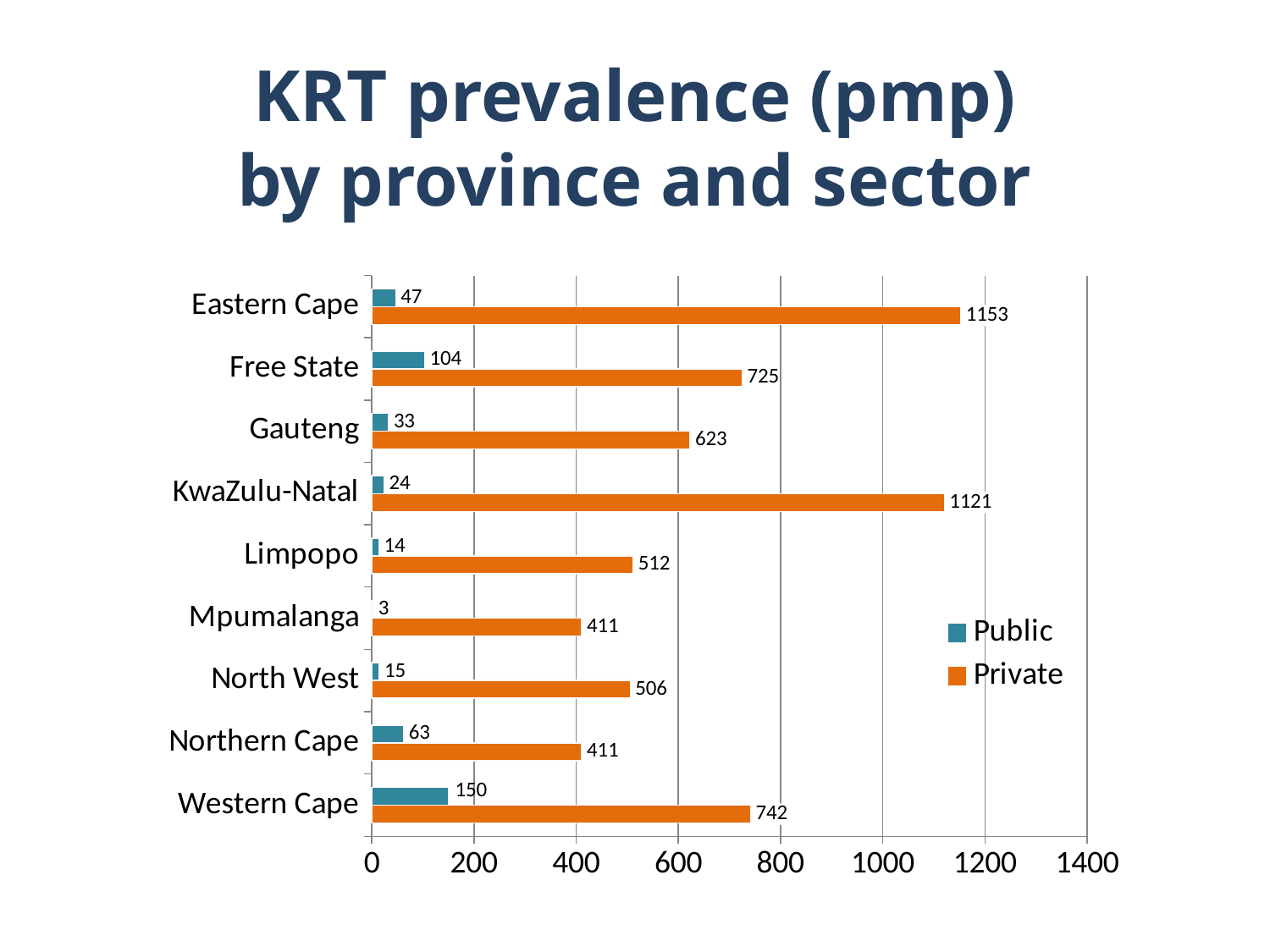
What is the Public value for Mpumalanga? 3 How many provinces are shown on the chart? 9 Which province has the highest Public KRT prevalence? Western Cape Which province has the highest Private KRT prevalence? Eastern Cape How many series does the legend list? 2 Which colour represents the Private series? Orange What is the difference between the Private and Public values for Free State? 621 What is the Private KRT prevalence for Eastern Cape? 1153 What kind of chart is shown on the slide? Bar chart Which is larger, the Private value for Gauteng or the Private value for Western Cape? Western Cape Which province has the lowest Public KRT prevalence? Mpumalanga What is the Public KRT prevalence for Western Cape? 150